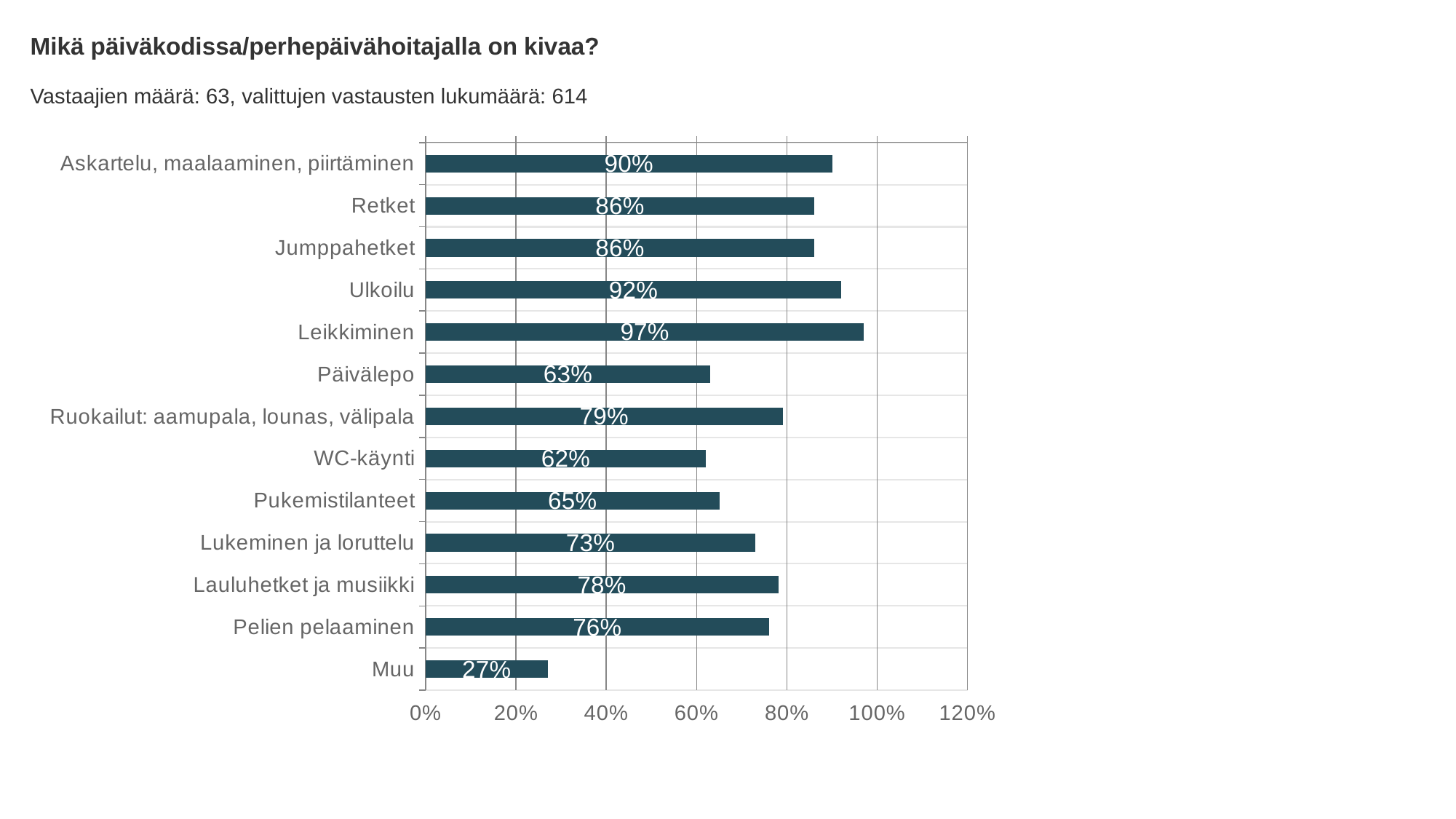
Which category has the lowest value? Muu What is the value for Leikkiminen? 97% How many categories are shown in the chart? 13 What kind of chart is shown on the slide? bar chart What is the value for Päivälepo? 63% What is the value for Ruokailut: aamupala, lounas, välipala? 79% What is the value for Muu? 27% Which category has the highest value? Leikkiminen What is the title of the chart? Mikä päiväkodissa/perhepäivähoitajalla on kivaa? What is the difference between the values for Ulkoilu and Pelien pelaaminen? 16% Is the value for WC-käynti greater or less than 80%? less Which is larger, the value for Lukeminen ja loruttelu or the value for Lauluhetket ja musiikki? Lauluhetket ja musiikki